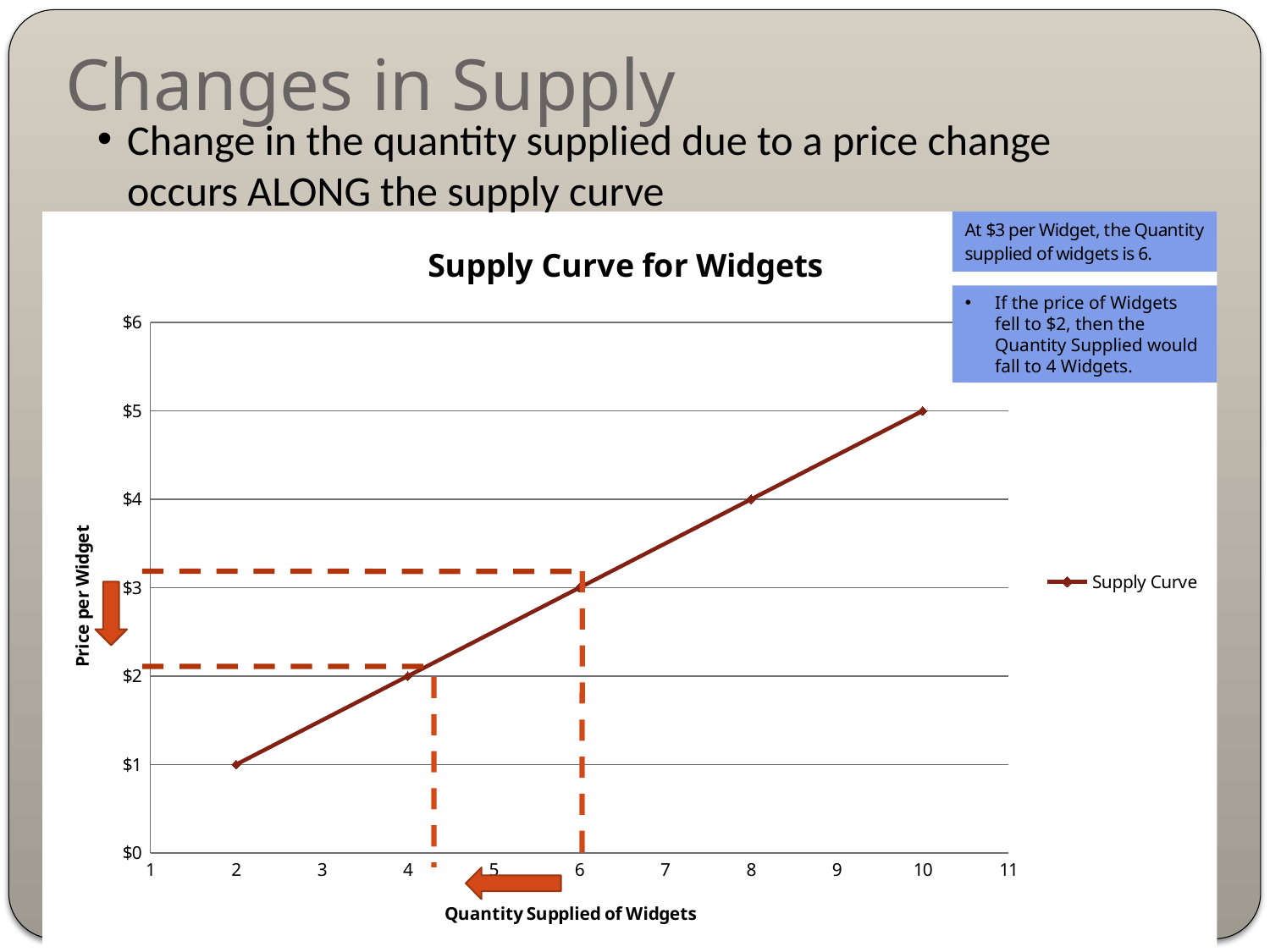
What is the price per widget when the quantity supplied is 6? $3 What kind of chart is shown on the slide? line chart Does the price per widget rise or fall as the quantity supplied increases along the x axis? rise What is the name of the series shown in the legend? Supply Curve What is the quantity supplied at a price of $1 per widget? 2 Which quantity supplied corresponds to the highest price on the supply curve? 10 How many series does the chart legend list? 1 What is the price per widget when the quantity supplied is 10? $5 What is the price per widget when the quantity supplied is 4? $2 What is the difference in price per widget between a quantity supplied of 6 and a quantity supplied of 4? $1 What is the title of the chart? Supply Curve for Widgets How many data points are plotted on the supply curve? 5